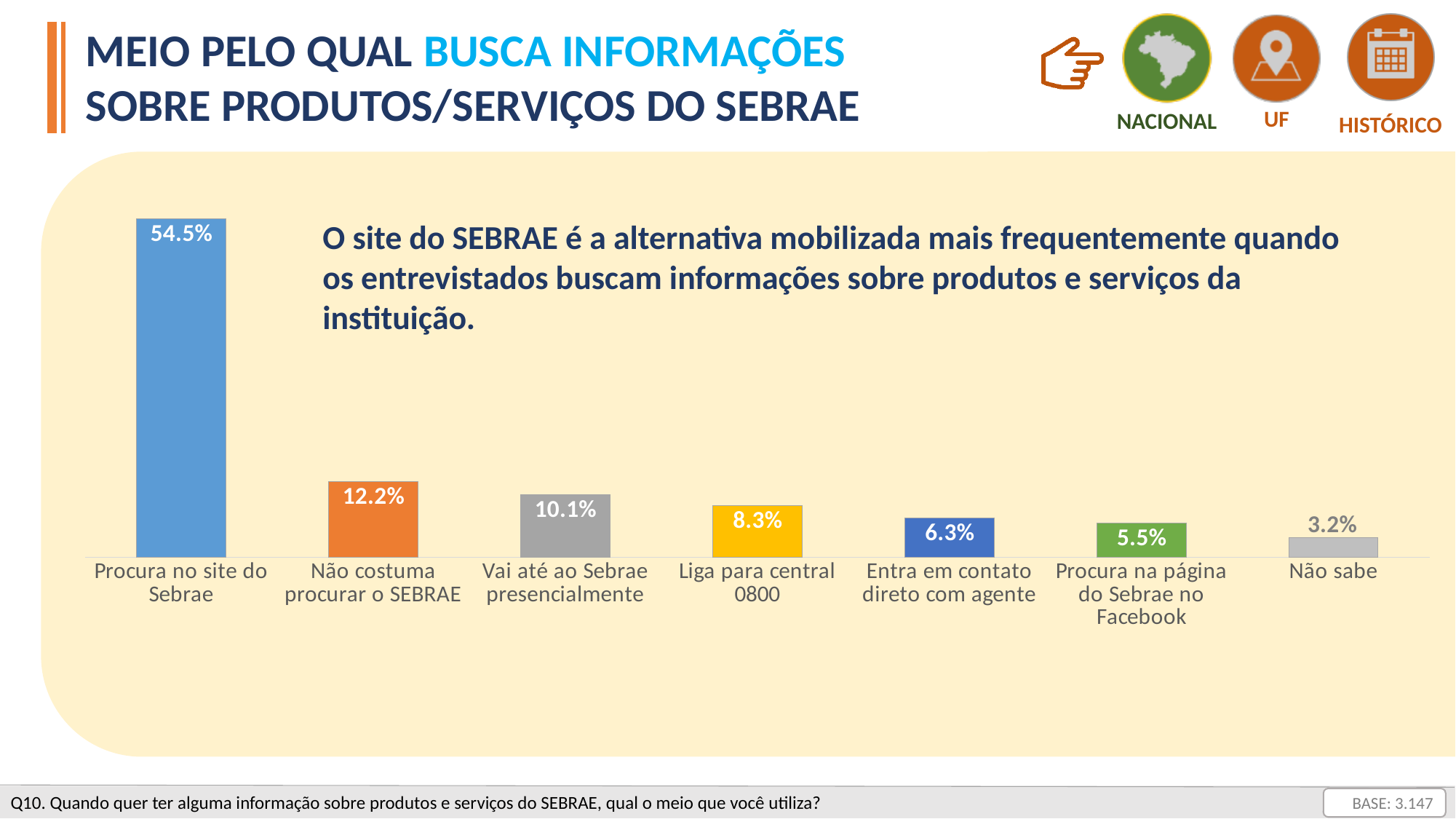
What is the difference between "Vai até ao Sebrae presencialmente" and "Entra em contato direto com agente"? 3.8% What is the value for "Procura no site do Sebrae"? 54.5% How many categories are shown in the chart? 7 Which category has the lowest value? Não sabe What is the value for "Procura na página do Sebrae no Facebook"? 5.5% What is the value for "Não sabe"? 3.2% Do the values rise or fall from left to right along the x axis? Fall What is the value for "Liga para central 0800"? 8.3% What kind of chart is shown on the slide? Bar chart Which category has the highest value? Procura no site do Sebrae Which is larger: "Não costuma procurar o SEBRAE" or "Vai até ao Sebrae presencialmente"? Não costuma procurar o SEBRAE What is the difference between "Procura no site do Sebrae" and "Não costuma procurar o SEBRAE"? 42.3%